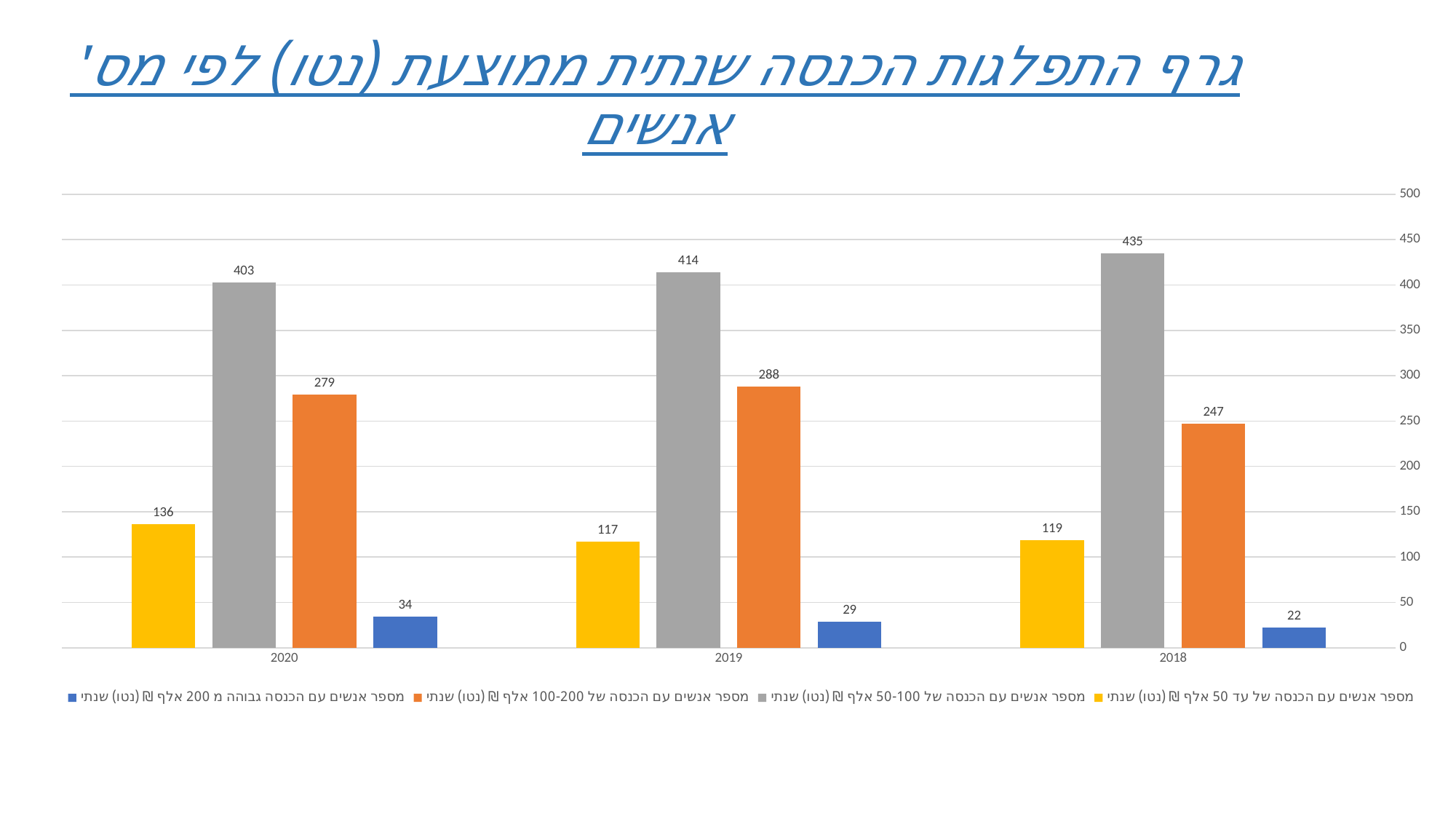
What is the value of the gray bar (income 50-100 thousand ₪) for 2020? 403 What is the value of the blue bar (income above 200 thousand ₪) for 2018? 22 What is the value of the orange bar (income 100-200 thousand ₪) for 2019? 288 Is the value of the yellow bar for 2019 greater or less than 150? less In which year is the gray bar (income 50-100 thousand ₪) highest? 2018 How many year categories are shown on the x axis? 3 Which is larger, the orange bar for 2020 or the orange bar for 2018? 2020 What type of chart is shown on the slide? bar chart What is the difference between the gray bar values for 2018 and 2020? 32 What is the value of the yellow bar (income up to 50 thousand ₪) for 2020? 136 How many series does the legend list? 4 In which year is the blue bar (income above 200 thousand ₪) lowest? 2018